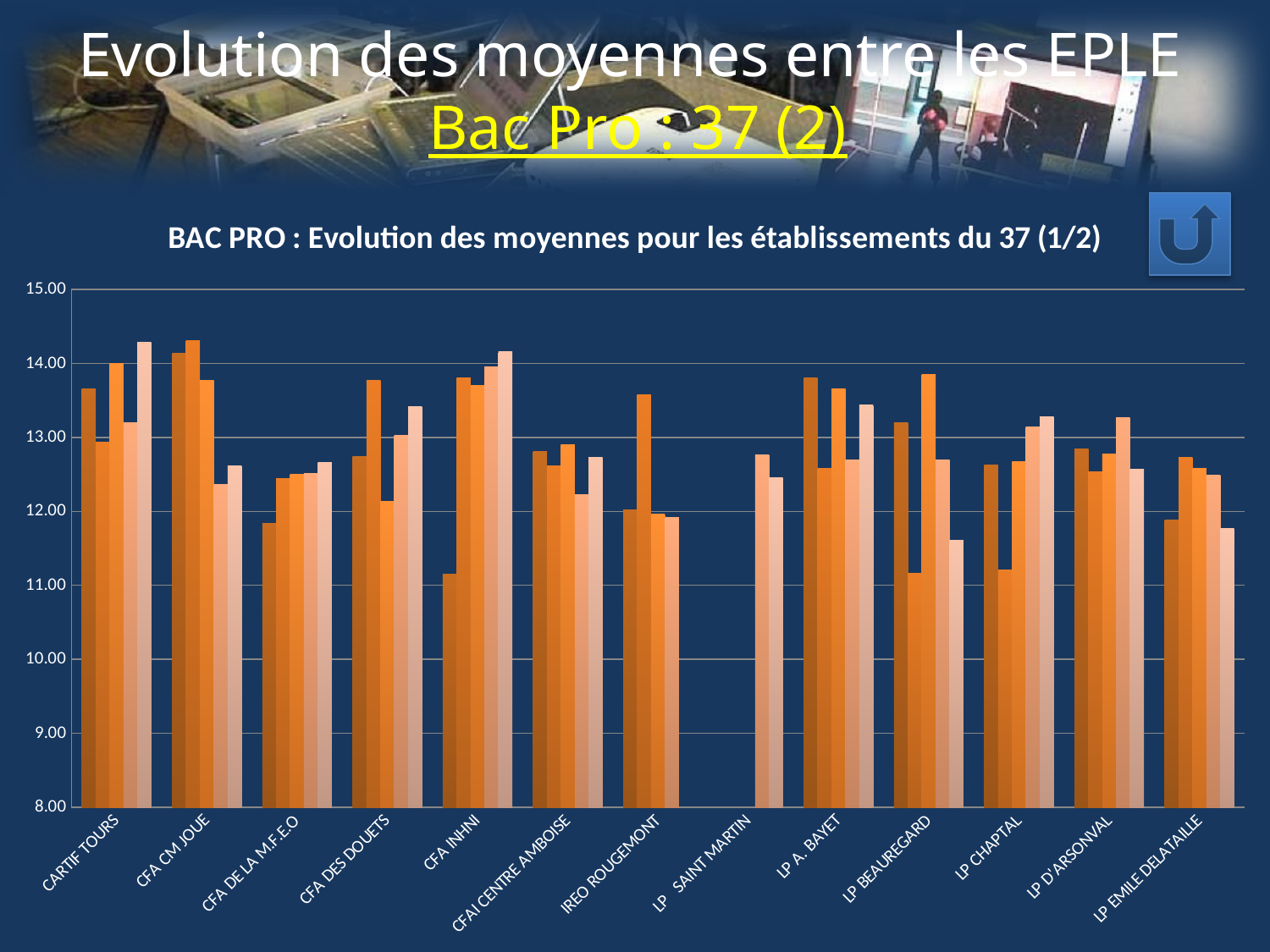
What is the title of the chart? BAC PRO : Evolution des moyennes pour les établissements du 37 (1/2) Is the tallest bar for LP SAINT MARTIN greater or less than 13.00? less How many establishments (categories) are shown on the x axis of the chart? 13 Is the shortest bar for LP BEAUREGARD greater or less than 12.00? less What kind of chart is shown on the slide? bar chart Is the tallest bar for CFA CM JOUE greater or less than 14.00? greater Which has a taller highest bar: CFA CM JOUE or CFA DE LA M.F.E.O? CFA CM JOUE Which has a taller highest bar: IREO ROUGEMONT or LP SAINT MARTIN? IREO ROUGEMONT What is the highest value shown on the chart's vertical axis? 15.00